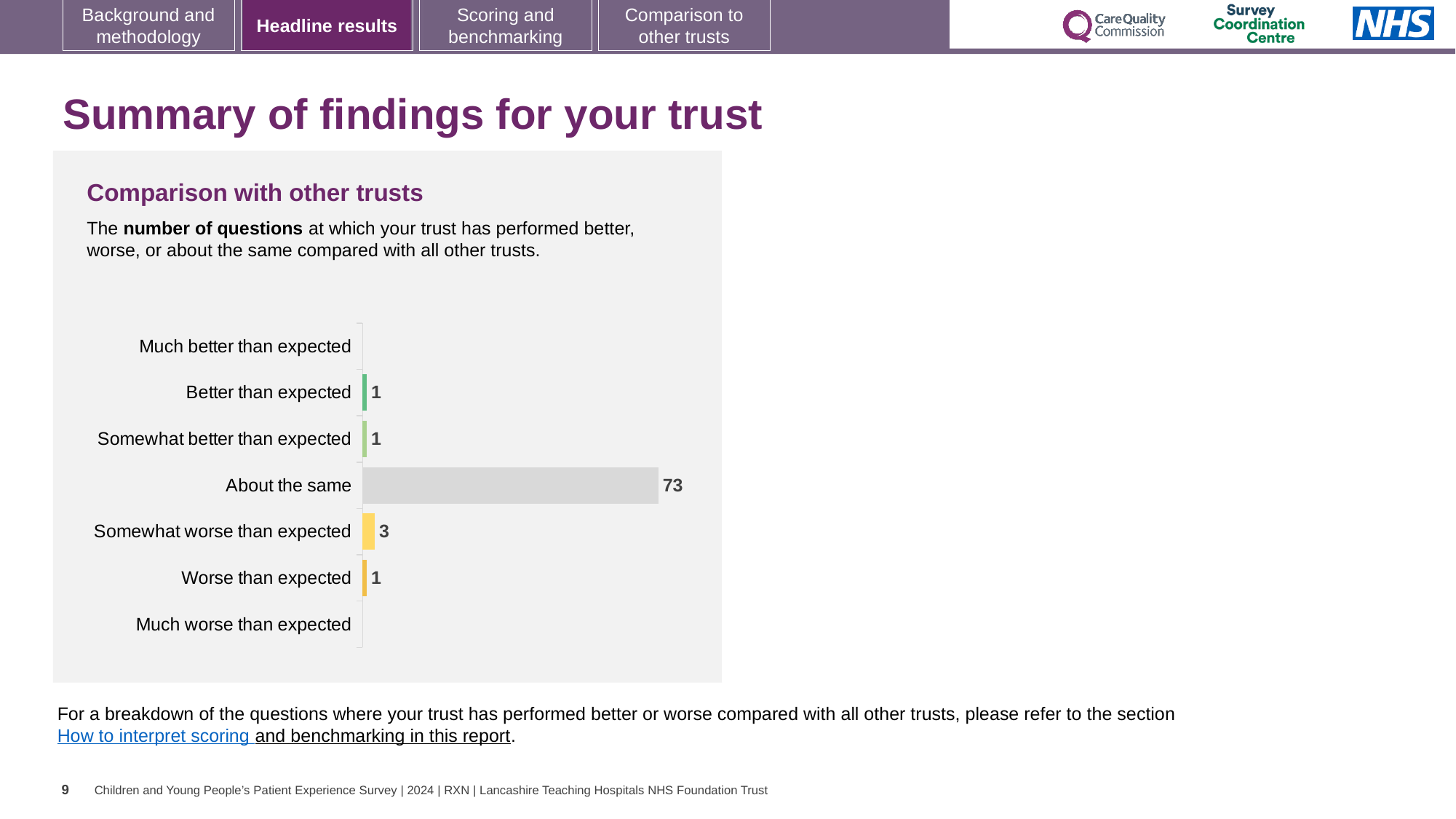
What is the difference between the values for "About the same" and "Somewhat worse than expected"? 70 What colour is the bar for "About the same"? Grey What is the total of the values for "Somewhat worse than expected" and "Worse than expected"? 4 What is the title of the chart? Comparison with other trusts What is the value for "About the same"? 73 What is the value for "Worse than expected"? 1 Which is larger, the value for "Somewhat worse than expected" or the value for "Somewhat better than expected"? Somewhat worse than expected How many categories are shown on the chart? 7 What is the value for "Somewhat worse than expected"? 3 What kind of chart is shown on the slide? Bar chart Which category has the highest value? About the same What is the value for "Better than expected"? 1